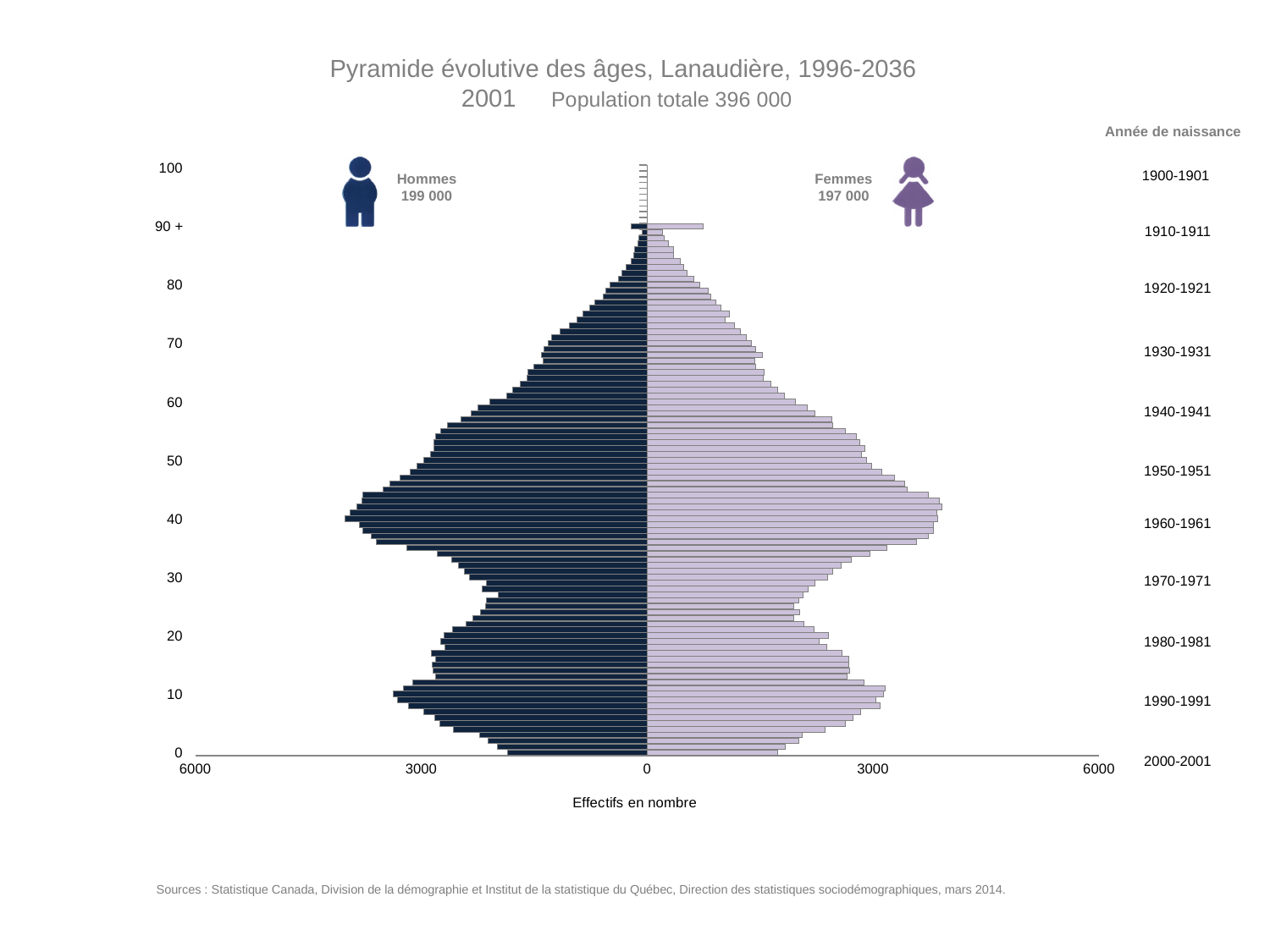
What is the total number of Femmes shown on the chart? 197 000 Is the value for Femmes at age 70 greater or less than 3000? less Is the value for Hommes at age 40 greater or less than 3000? greater What is the total number of Hommes shown on the chart? 199 000 What is the difference between the Hommes total and the Femmes total? 2 000 What is the total population shown in the chart subtitle? 396 000 What is the label of the horizontal axis? Effectifs en nombre Do the Hommes bars rise or fall as age increases from 40 to 80? fall How many groups (sexes) does the chart show? 2 What kind of chart is shown on the slide? Bar chart (population pyramid) Which group has the larger total, Hommes or Femmes? Hommes Is the value for Hommes at age 80 greater or less than 3000? less